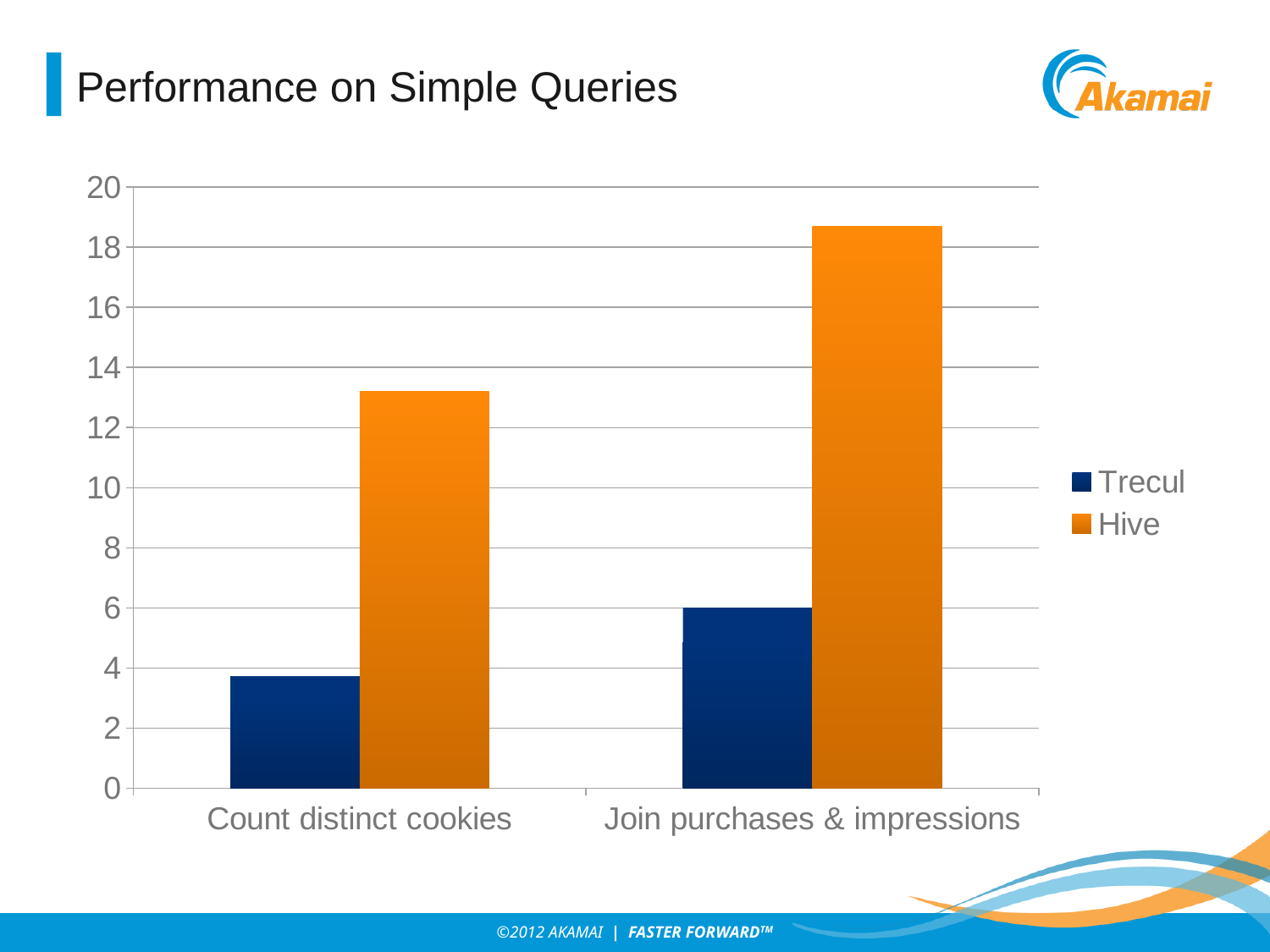
Which series has the tallest bar in the chart? Hive Is the Trecul value for Count distinct cookies greater or less than 4? less Is the Hive value for Count distinct cookies greater or less than 12? greater For Join purchases & impressions, which series has the larger value, Trecul or Hive? Hive What kind of chart is shown on the slide? bar chart How many query categories are shown on the x axis? 2 Which category has the lowest Trecul value? Count distinct cookies What is the title of the slide containing the chart? Performance on Simple Queries Which colour represents the Trecul series in the legend? dark blue Is the Hive value for Join purchases & impressions greater or less than 18? greater How many series does the legend list? 2 Which category has the higher Hive value? Join purchases & impressions